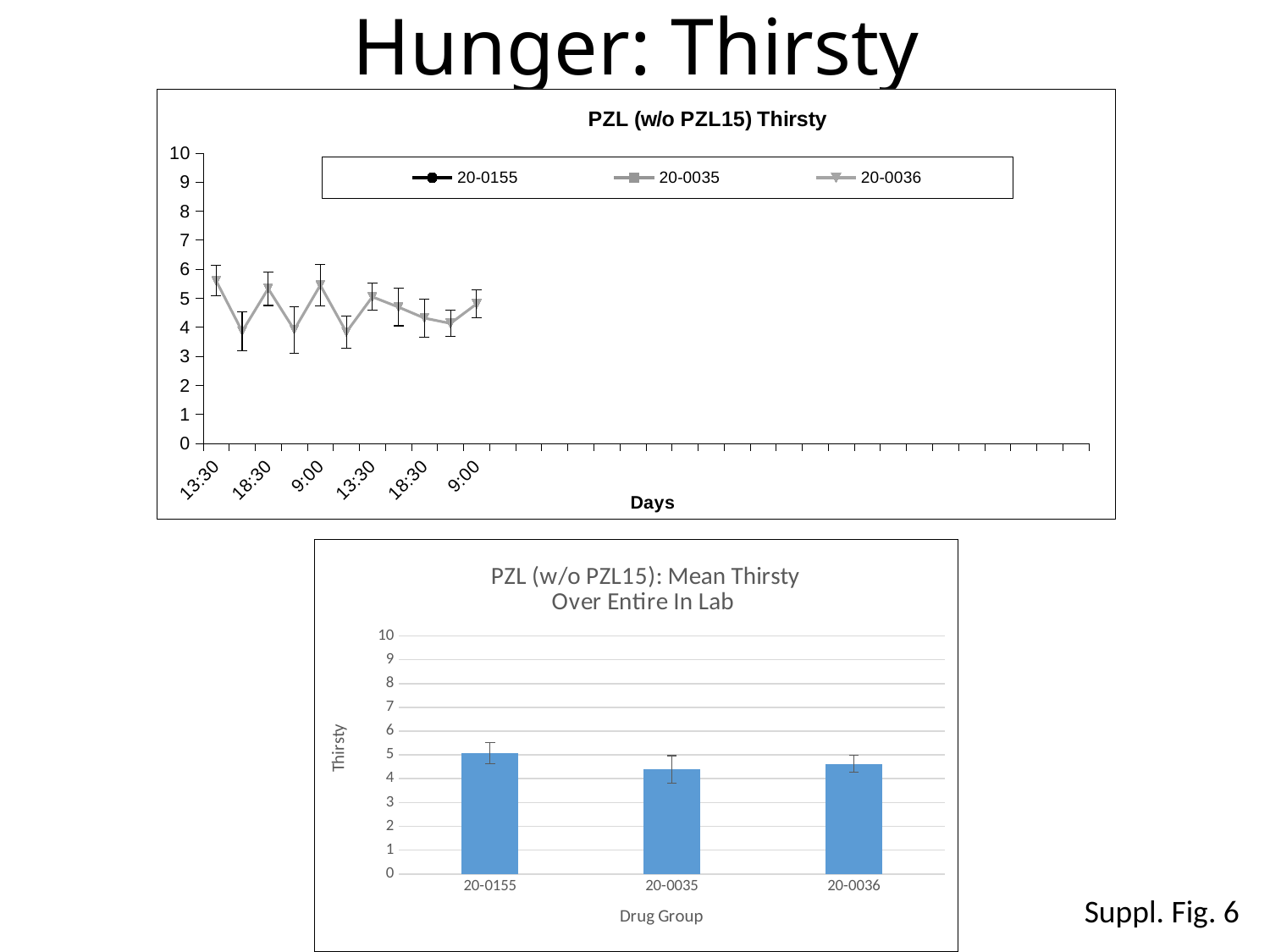
In the top chart "PZL (w/o PZL15) Thirsty", is the first plotted point (at 13:30) greater or less than 5? greater How many series does the legend of the top chart "PZL (w/o PZL15) Thirsty" list? 3 In the bottom chart "PZL (w/o PZL15): Mean Thirsty Over Entire In Lab", which bar is taller, 20-0155 or 20-0035? 20-0155 How many drug groups are shown as bars in the bottom chart "PZL (w/o PZL15): Mean Thirsty Over Entire In Lab"? 3 What is the x-axis title of the top chart "PZL (w/o PZL15) Thirsty"? Days In the top chart "PZL (w/o PZL15) Thirsty", is the second plotted point greater or less than 5? less What kind of chart is the top chart titled "PZL (w/o PZL15) Thirsty"? line chart In the bottom chart "PZL (w/o PZL15): Mean Thirsty Over Entire In Lab", which drug group has the highest bar? 20-0155 In the bottom chart "PZL (w/o PZL15): Mean Thirsty Over Entire In Lab", is the bar for 20-0035 greater or less than 5? less What kind of chart is the bottom chart titled "PZL (w/o PZL15): Mean Thirsty Over Entire In Lab"? bar chart What is the x-axis title of the bottom chart "PZL (w/o PZL15): Mean Thirsty Over Entire In Lab"? Drug Group